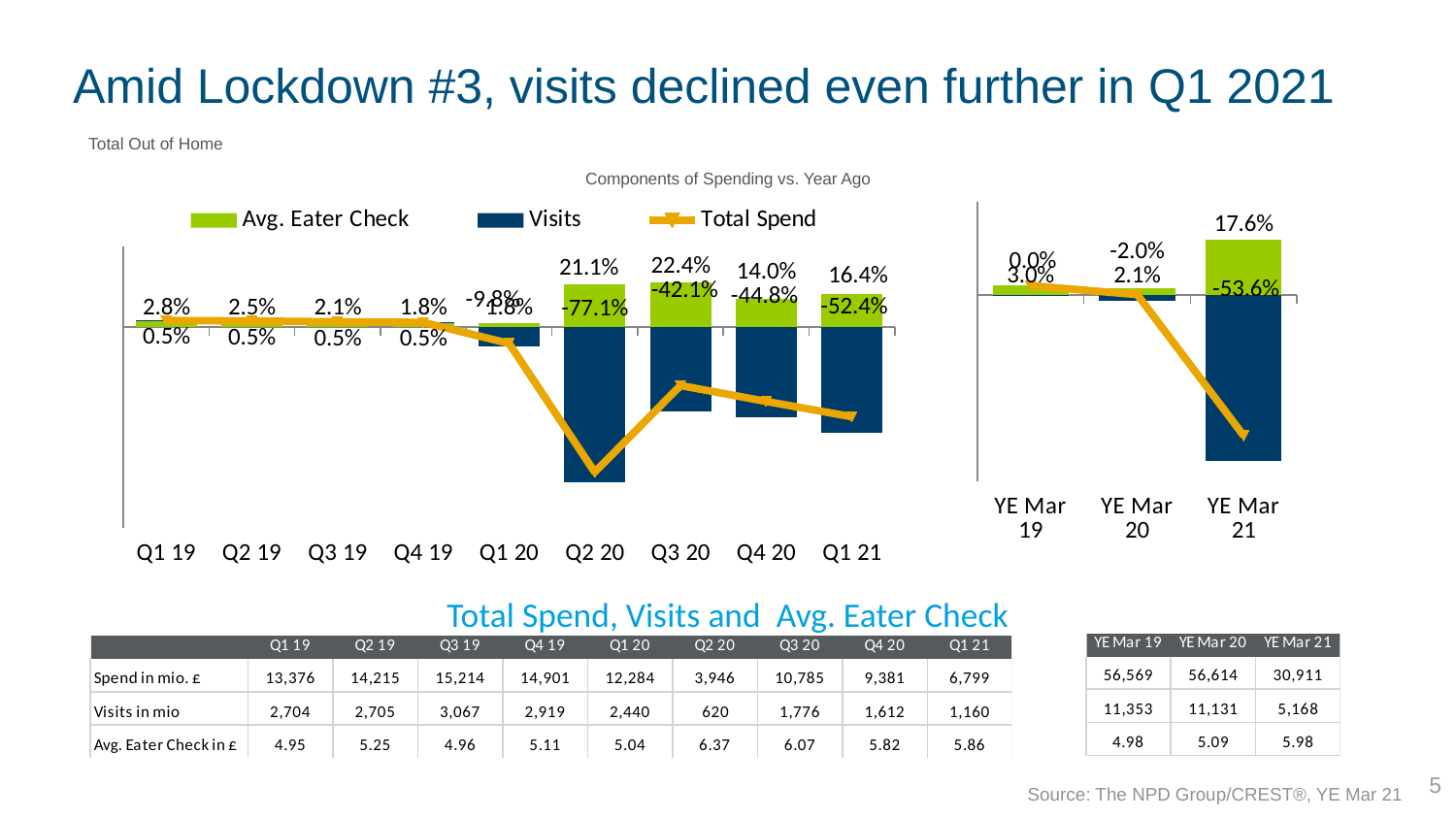
How many series does the legend of the Components of Spending vs. Year Ago chart list? 3 In the left chart (Components of Spending vs. Year Ago, quarterly), what kind of chart is used? Bar chart with a line In the left quarterly chart, what is the difference between the Avg. Eater Check values for Q3 20 and Q4 20? 8.4 percentage points In the right chart (YE Mar), what is the Visits value for YE Mar 21? -53.6% In the Components of Spending vs. Year Ago chart, what colour represents Visits in the legend? Dark blue In the left quarterly chart, do the Avg. Eater Check values rise or fall from Q1 19 to Q4 19? Fall In the left quarterly chart, what is the Visits value for Q2 20? -77.1% In the left quarterly chart, how many quarters are shown on the x axis? 9 In the left quarterly chart, which quarter has the lowest Visits value? Q2 20 In the left quarterly chart, which quarter has the highest Avg. Eater Check value? Q3 20 In the left quarterly chart, which is larger, the Visits value for Q3 20 or for Q4 20? Q3 20 In the left quarterly chart, what is the Avg. Eater Check value for Q3 20? 22.4%